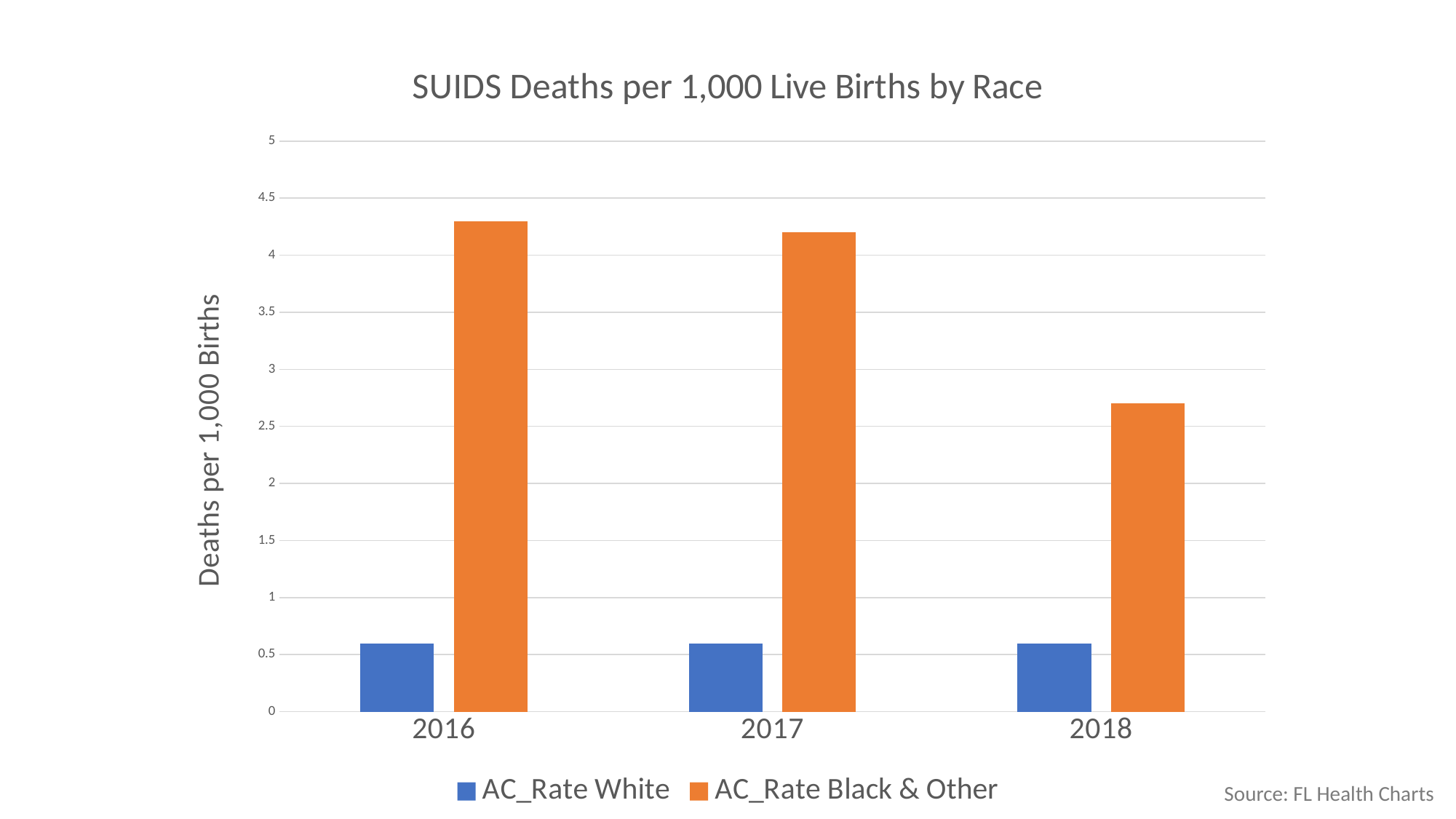
Do the values for AC_Rate Black & Other rise or fall from 2016 to 2018? fall Which year has the lowest value for AC_Rate Black & Other? 2018 Is the value for AC_Rate Black & Other in 2016 greater or less than 4? greater Is the value for AC_Rate White in 2017 greater or less than 1? less What is the label on the vertical axis? Deaths per 1,000 Births Is the value for AC_Rate Black & Other in 2018 greater or less than 3? less How many series does the legend list? 2 Which is larger in 2018, AC_Rate White or AC_Rate Black & Other? AC_Rate Black & Other What kind of chart is shown on the slide? bar chart How many years are shown on the x axis? 3 What is the title of the chart? SUIDS Deaths per 1,000 Live Births by Race